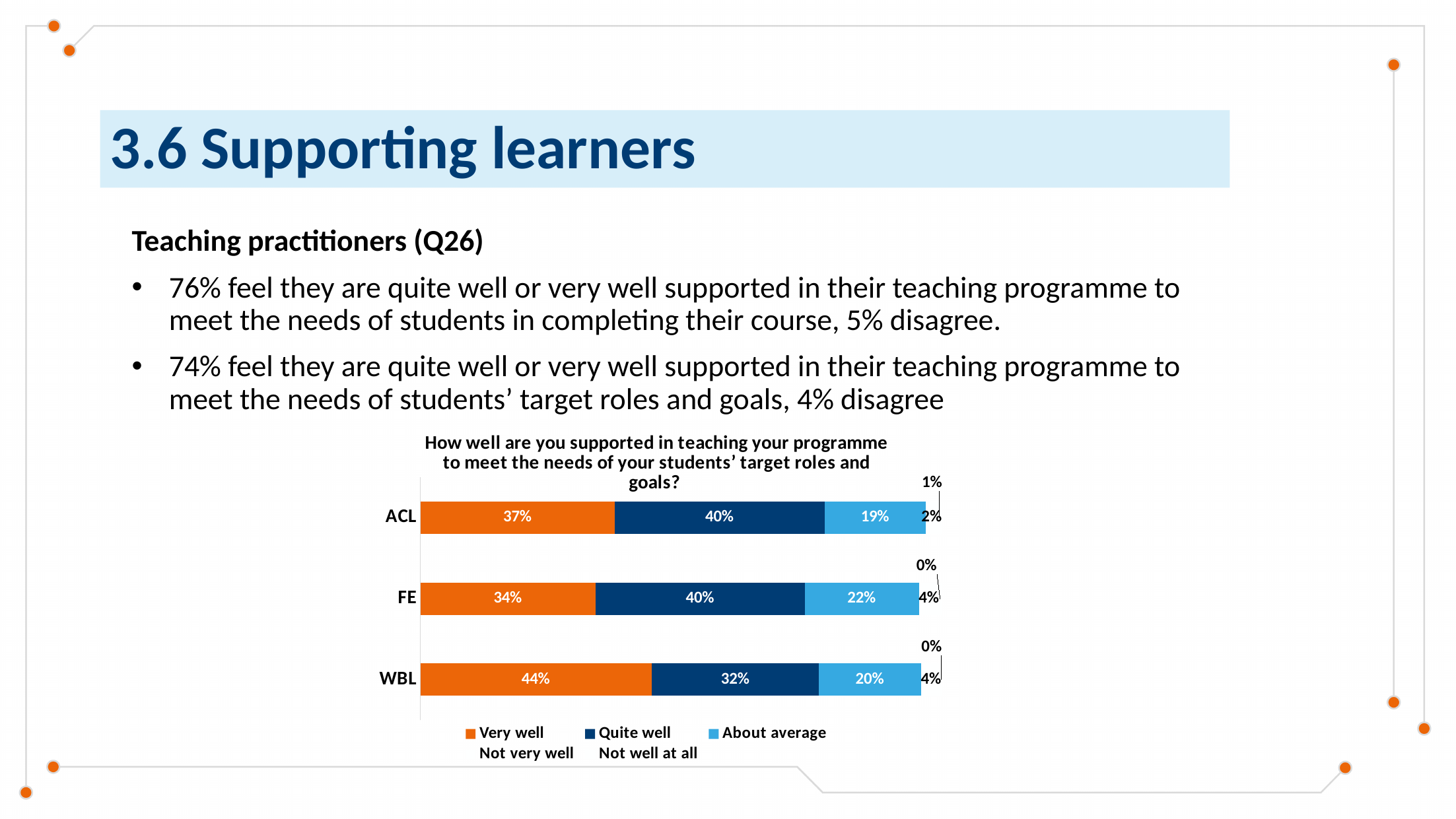
Which is larger: the 'About average' percentage for FE or for ACL? FE What type of chart is shown on the slide? Stacked bar chart What is the combined 'Very well' and 'Quite well' percentage for ACL? 77% What percentage of FE respondents answered 'About average'? 22% What percentage of ACL respondents answered 'Very well'? 37% How many categories are shown on the chart? 3 How many series does the legend list? 5 Which series is shown in orange in the chart? Very well Which category has the highest 'Very well' percentage? WBL What percentage of WBL respondents answered 'Quite well'? 32% What is the difference between the 'Very well' percentages for WBL and FE? 10% Which category has the lowest 'Quite well' percentage? WBL